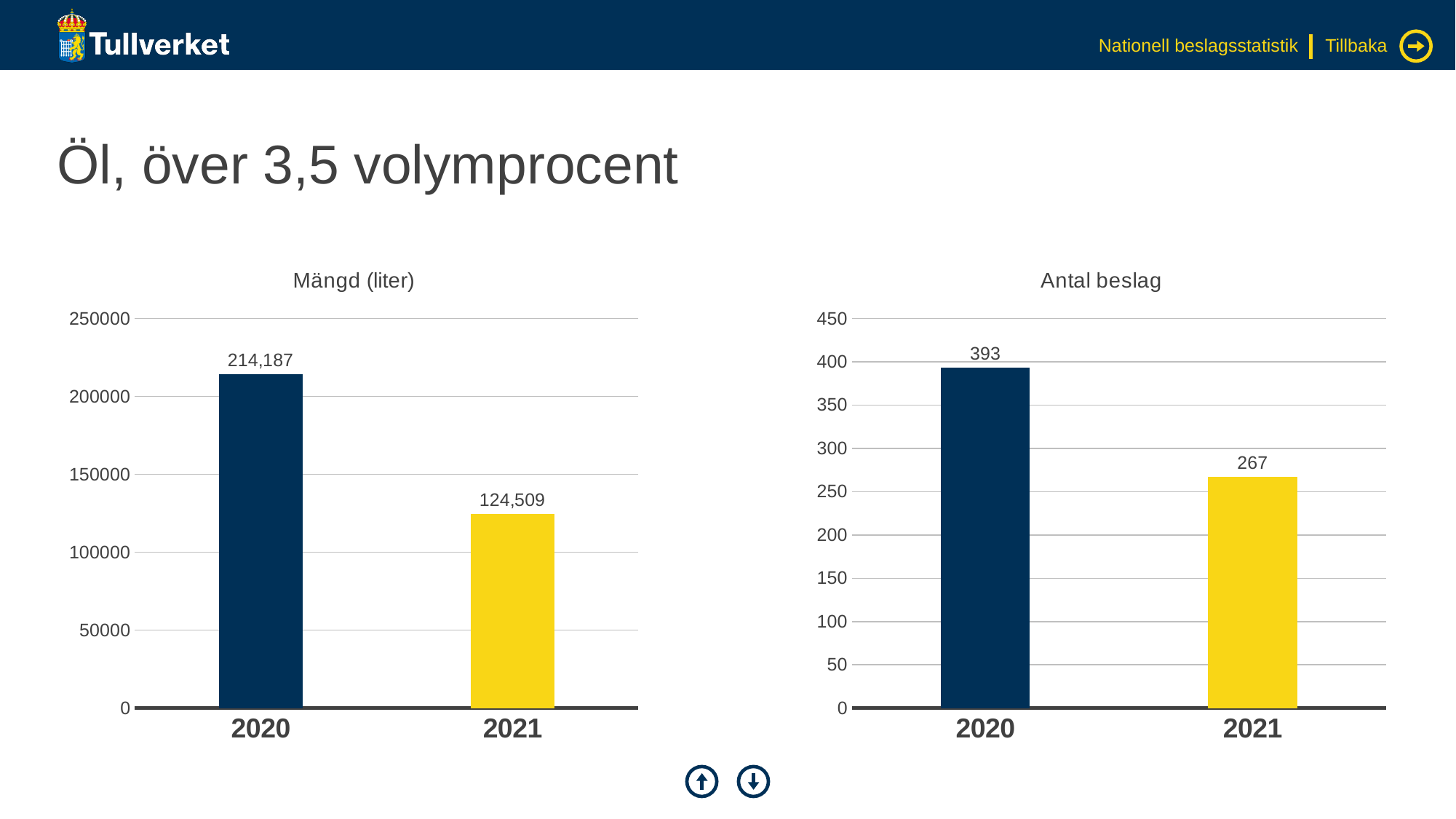
What kind of chart is the 'Antal beslag' chart? Bar chart In the 'Mängd (liter)' chart, what is the difference between the values for 2020 and 2021? 89,678 In the 'Antal beslag' chart, is the value for 2021 greater or less than 250? greater In the 'Antal beslag' chart, which year has the lowest value? 2021 In the 'Antal beslag' chart, what is the value for 2020? 393 In the 'Mängd (liter)' chart, which year has the highest value? 2020 In the 'Mängd (liter)' chart, what is the value for 2021? 124,509 In the 'Mängd (liter)' chart, do the values rise or fall from 2020 to 2021? Fall In the 'Antal beslag' chart, what is the difference between the values for 2020 and 2021? 126 In the 'Mängd (liter)' chart, how many years are shown on the x axis? 2 In the 'Mängd (liter)' chart, what is the value for 2020? 214,187 In the 'Antal beslag' chart, what is the value for 2021? 267